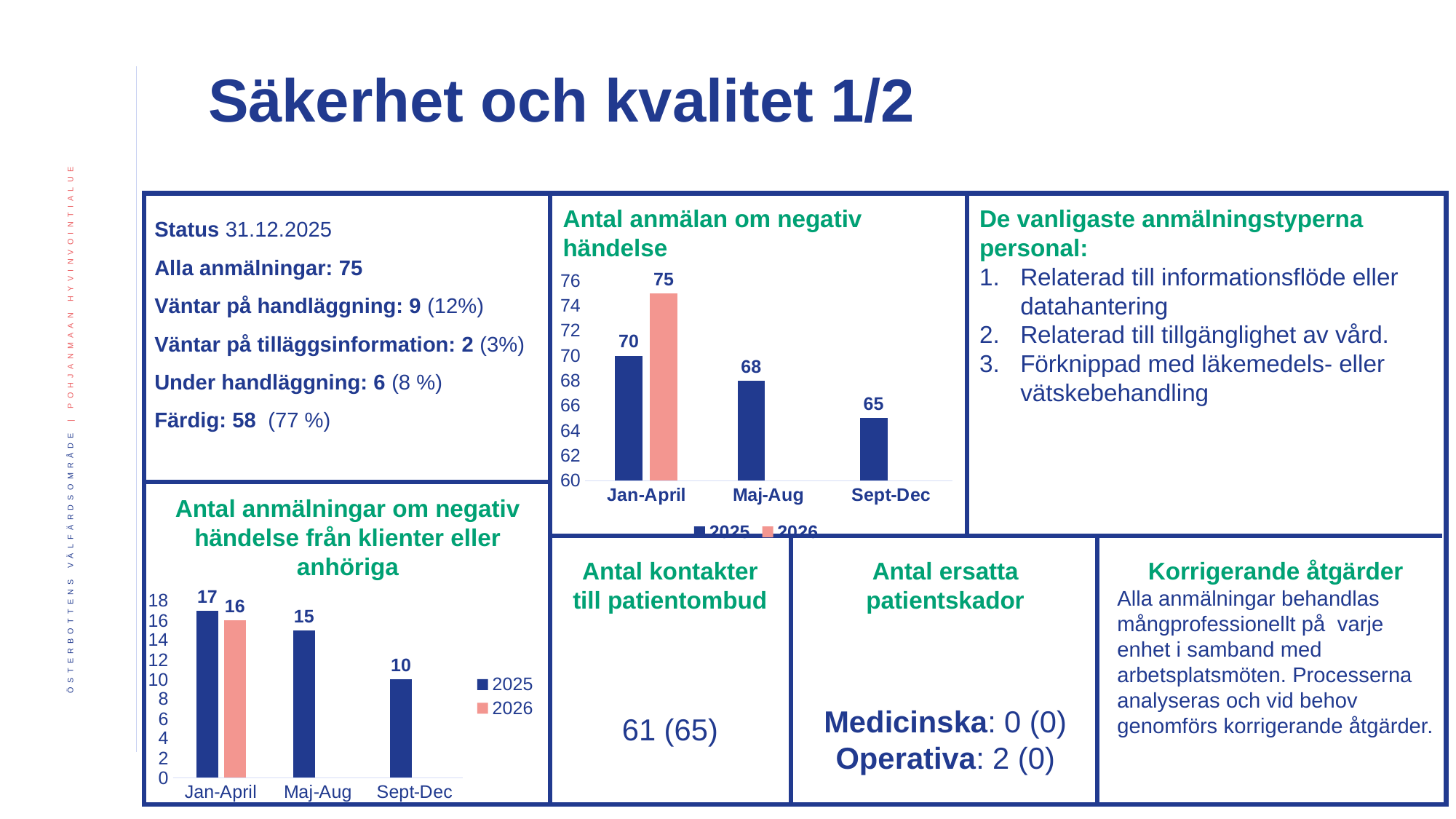
In the chart 'Antal anmälan om negativ händelse', which period has the lowest 2025 value? Sept-Dec In the chart 'Antal anmälningar om negativ händelse från klienter eller anhöriga', what is the 2025 value for Maj-Aug? 15 What type of chart is 'Antal anmälningar om negativ händelse från klienter eller anhöriga'? bar chart In the chart 'Antal anmälan om negativ händelse', what is the difference between the 2026 and 2025 values for Jan-April? 5 In the chart 'Antal anmälan om negativ händelse', do the 2025 values rise or fall from Jan-April to Sept-Dec? fall In the chart 'Antal anmälan om negativ händelse', what is the 2025 value for Jan-April? 70 In the chart 'Antal anmälningar om negativ händelse från klienter eller anhöriga', which period has the highest 2025 value? Jan-April In the chart 'Antal anmälan om negativ händelse', what is the 2025 value for Sept-Dec? 65 In the chart 'Antal anmälan om negativ händelse', what is the 2026 value for Jan-April? 75 In the chart 'Antal anmälningar om negativ händelse från klienter eller anhöriga', what is the 2026 value for Jan-April? 16 In the chart 'Antal anmälningar om negativ händelse från klienter eller anhöriga', what is the difference between the 2025 values for Jan-April and Sept-Dec? 7 In the chart 'Antal anmälan om negativ händelse', how many series does the legend list? 2